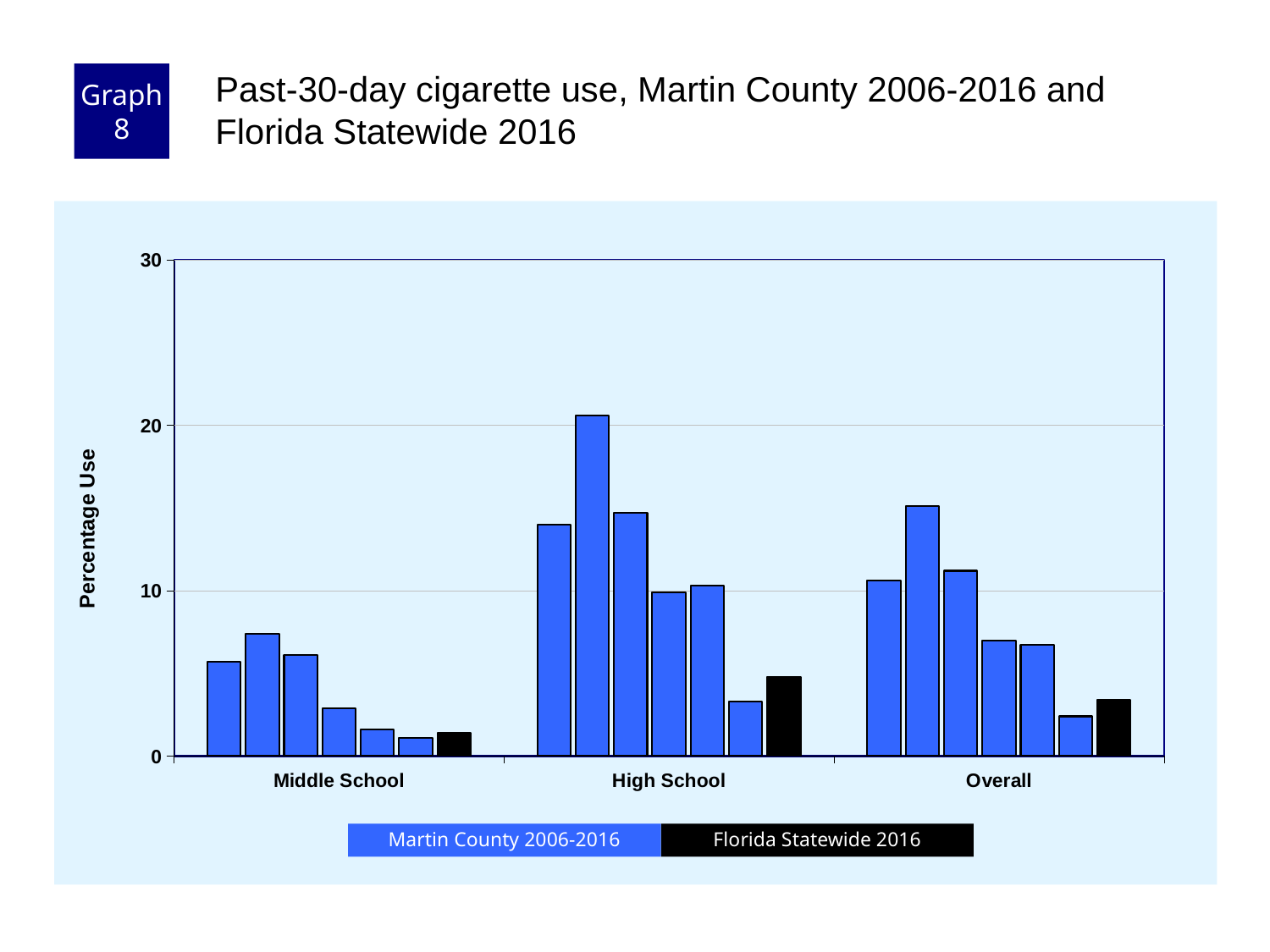
In the Middle School group, is the last Martin County 2006-2016 bar higher or lower than the first? lower Which category contains the tallest bar in the chart? High School Is the tallest bar in the Middle School group greater or less than 10? less What colour are the Florida Statewide 2016 bars? black Is the tallest bar in the High School group greater or less than 20? greater Is the tallest bar in the Overall group greater or less than 10? greater How many school-level categories are shown on the x axis? 3 How many series does the legend list? 2 What kind of chart is shown on the slide? bar chart Which category has the lowest Florida Statewide 2016 bar? Middle School Which is larger, the Florida Statewide 2016 bar for High School or the Florida Statewide 2016 bar for Overall? High School